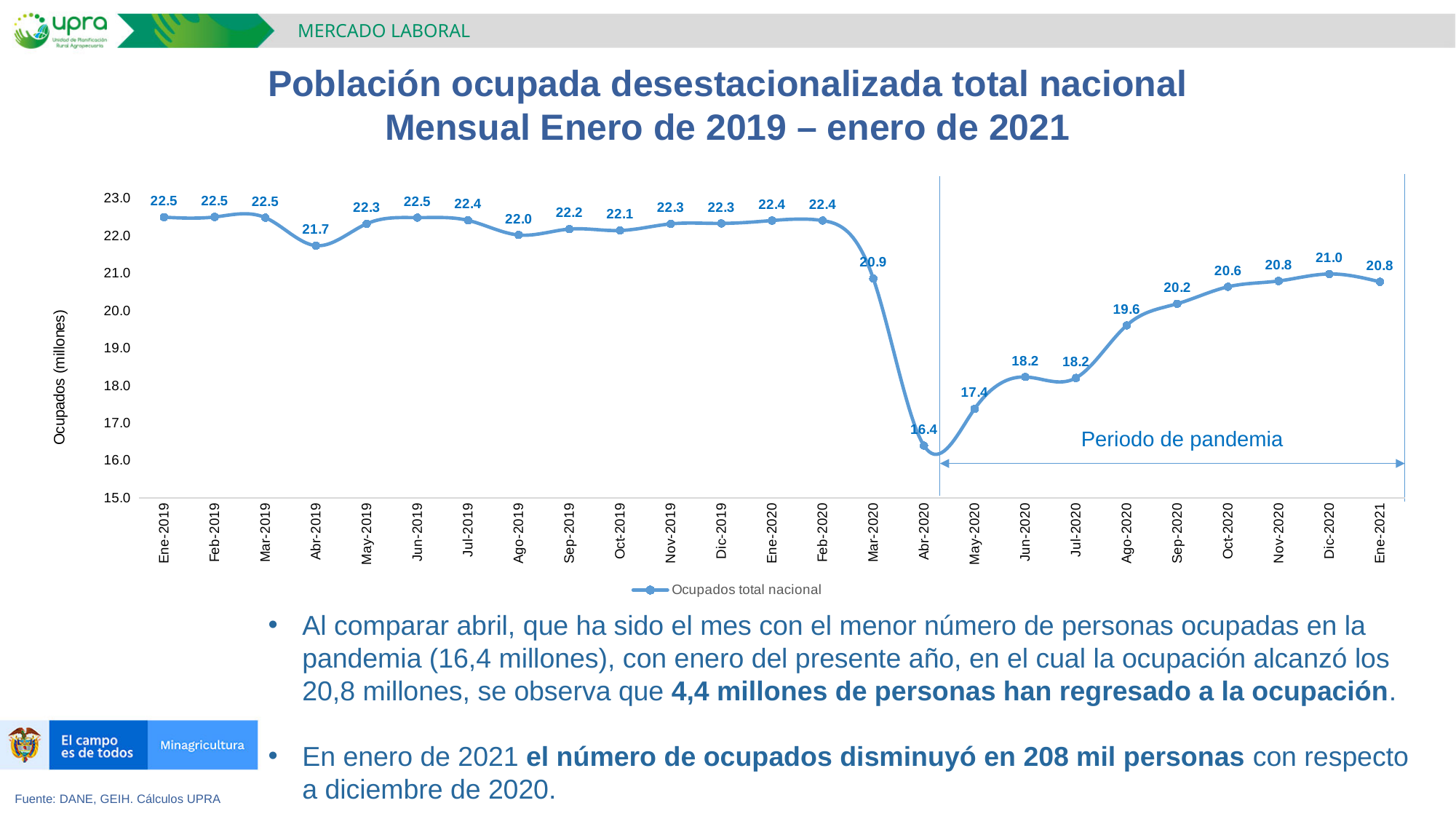
What is the difference between the values for Ene-2021 and Abr-2020? 4.4 What is the value for Ene-2021? 20.8 How many series does the legend list? 1 What is the value for Mar-2020? 20.9 Which month has the lowest value? Abr-2020 What is the difference between the values for Dic-2020 and Ene-2021? 0.2 What is the value for Abr-2020? 16.4 Do the values rise or fall from Abr-2020 to Dic-2020? Rise Which is larger, the value for Mar-2020 or the value for Abr-2020? Mar-2020 How many data points are plotted on the chart? 25 What type of chart is shown on the slide? Line chart What is the value for Abr-2019? 21.7